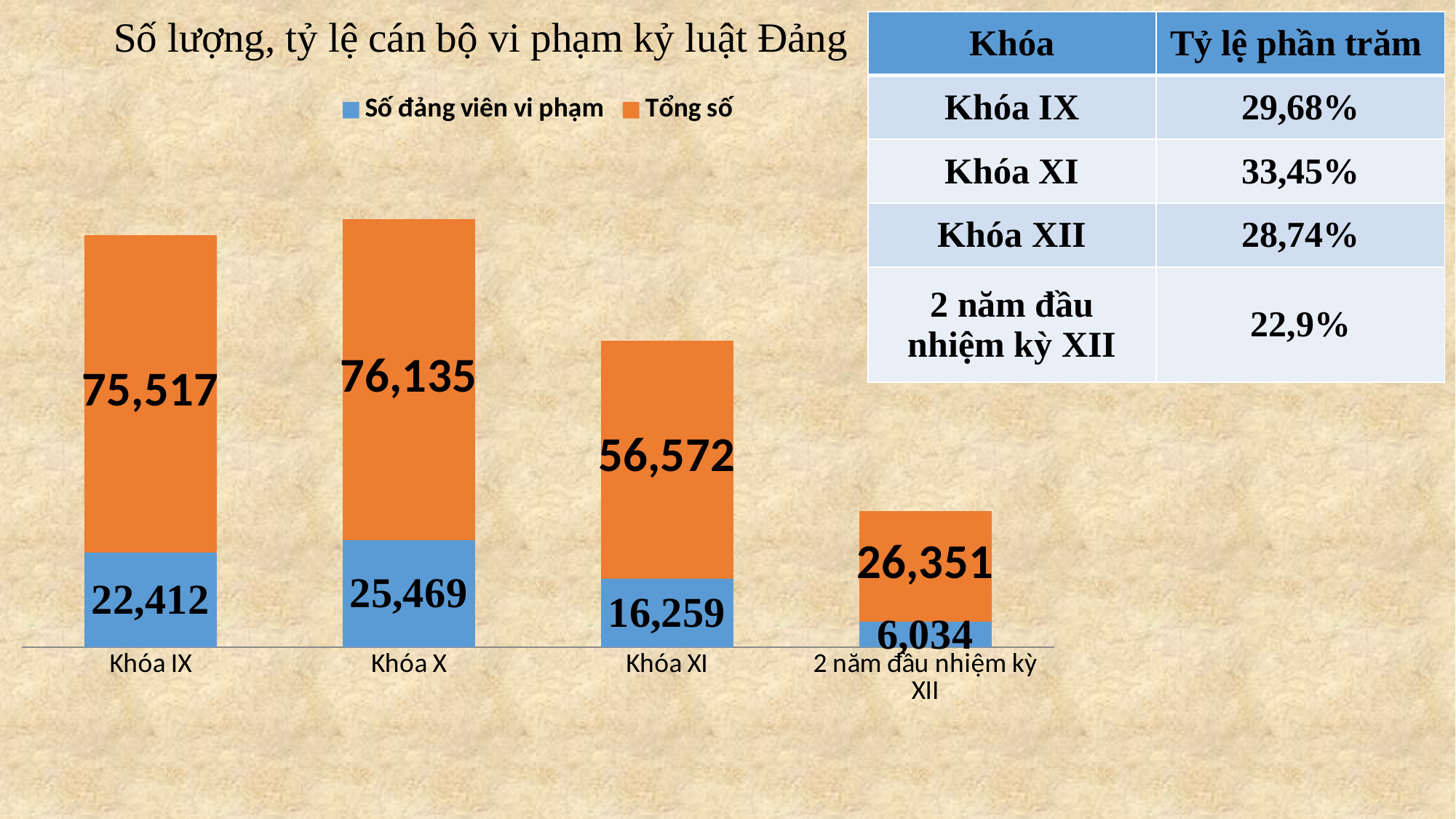
Which category has the lowest Số đảng viên vi phạm value? 2 năm đầu nhiệm kỳ XII What is the value of Tổng số for Khóa IX? 75,517 What is the value of Tổng số for Khóa XI? 56,572 Which is larger: Số đảng viên vi phạm for Khóa IX or for Khóa XI? Khóa IX How many series does the chart legend list? 2 What type of chart is shown on the slide? Stacked bar chart What is the value of Số đảng viên vi phạm for 2 năm đầu nhiệm kỳ XII? 6,034 How many categories are shown on the x axis of the chart? 4 Which category has the highest Tổng số value? Khóa X What is the difference between the Số đảng viên vi phạm values for Khóa IX and Khóa XI? 6,153 What is the value of Số đảng viên vi phạm for Khóa X? 25,469 What is the difference between the Tổng số values for Khóa X and Khóa IX? 618